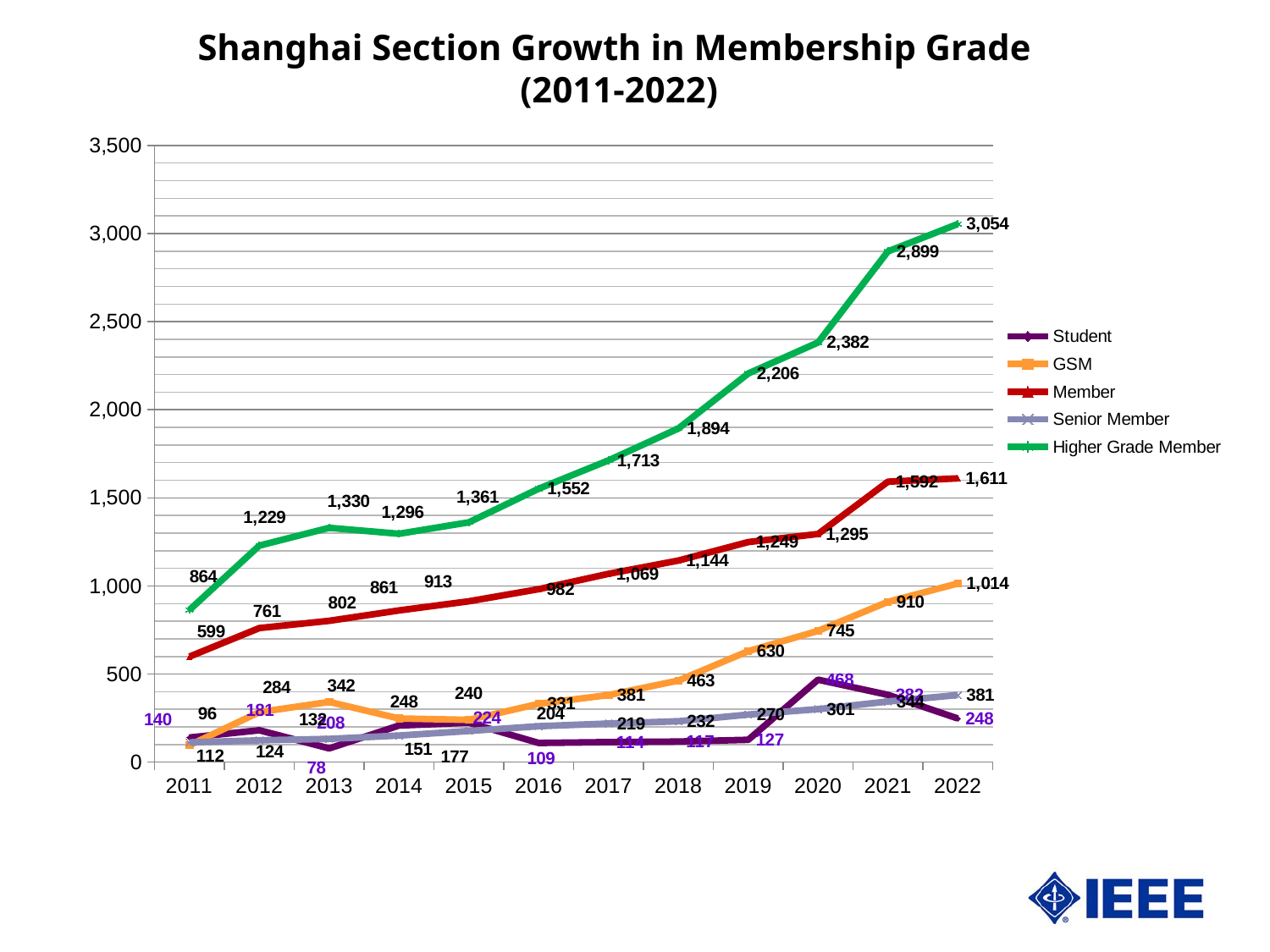
What is the Student value for 2020? 468 Which is larger in 2022, the Member value or the GSM value? Member In which year is the Student series at its lowest? 2013 How many years are plotted along the x axis? 12 What is the Higher Grade Member value for 2022? 3,054 What is the Member value for 2011? 599 How many series does the legend list? 5 Which series has the highest value in 2022? Higher Grade Member What kind of chart is shown on the slide? line chart Does the Higher Grade Member series rise or fall overall from 2011 to 2022? rises By how much did the Higher Grade Member value increase from 2021 to 2022? 155 What is the GSM value for 2022? 1,014